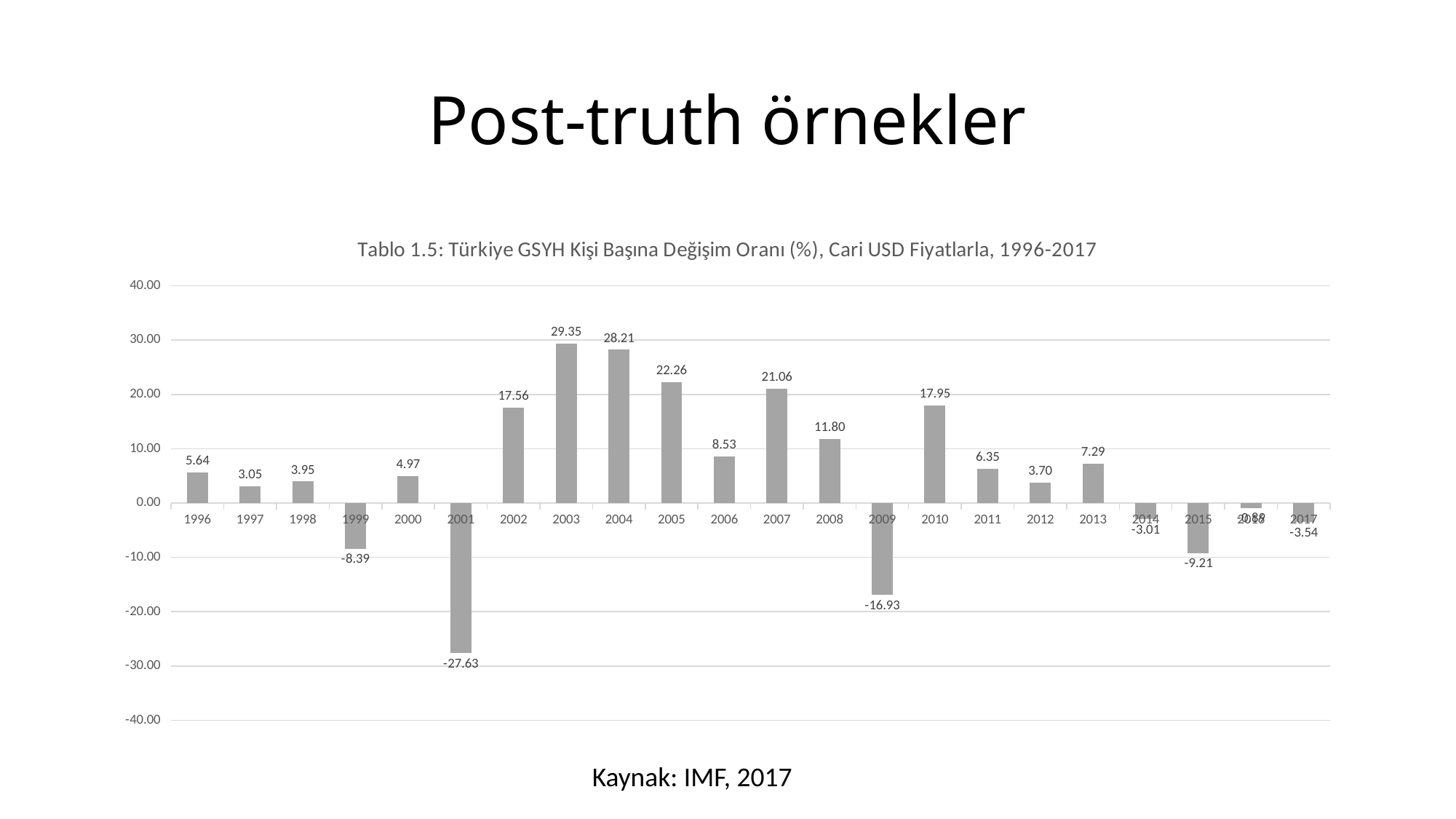
What is the source cited below the chart? IMF, 2017 What is the value for 2010? 17.95 Which year has the lowest value? 2001 What is the value for 2009? -16.93 What kind of chart is shown on the slide? bar chart Which year has the highest value? 2003 How many years are shown on the x axis? 22 What is the value for 2001? -27.63 What is the difference between the values for 2003 and 2004? 1.14 Is the value for 2002 greater or less than 20.00? less What is the value for 2003? 29.35 Which is larger, the value for 2005 or the value for 2007? 2005